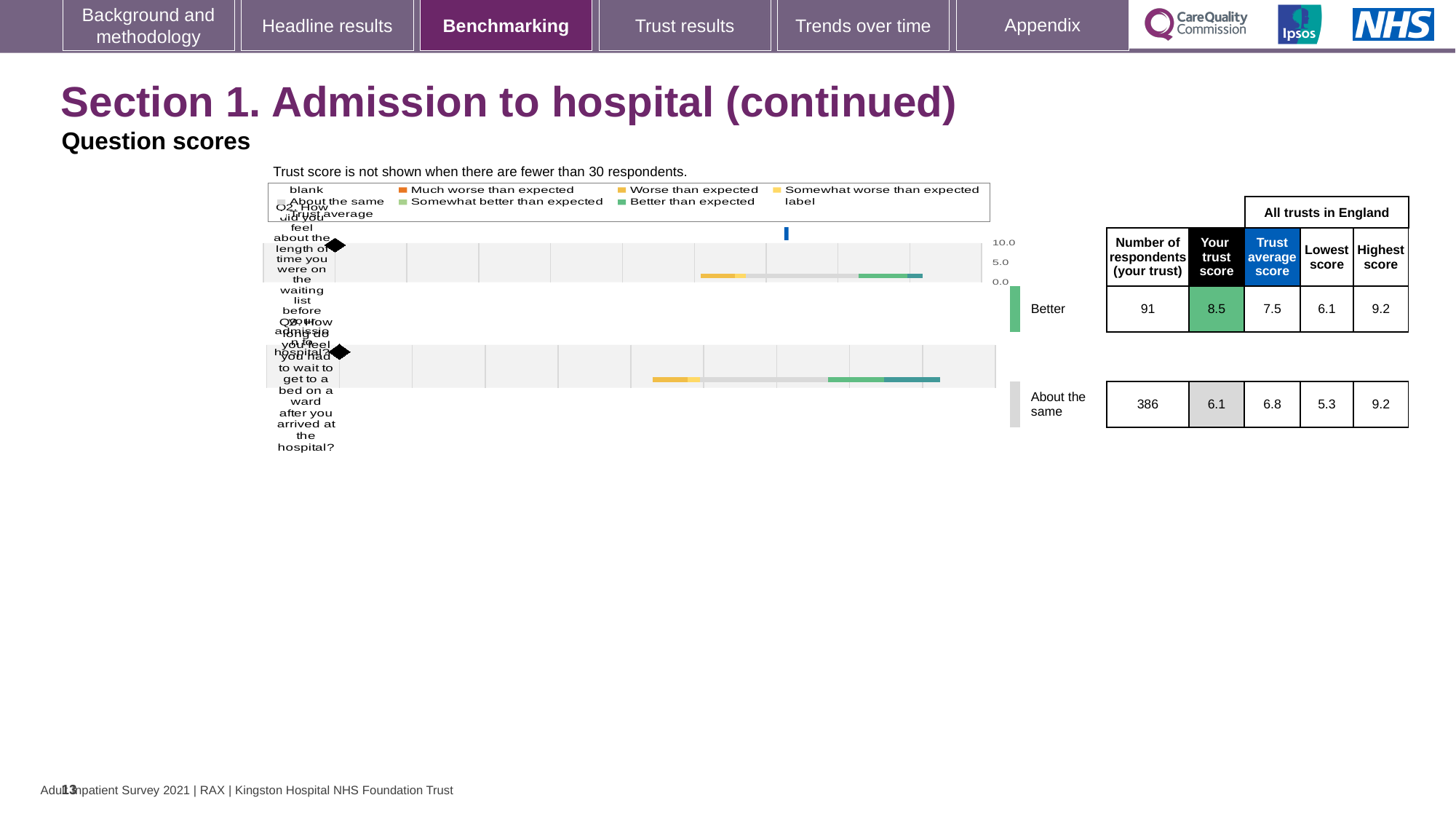
Which benchmark category is shown for Q3? About the same By how much does the trust score for Q2 exceed the trust average score for Q2? 1.0 What is the difference between the highest and lowest scores across all trusts for Q3? 3.9 What kind of chart is used to show the question scores on this slide? Bar chart What is the trust score for Q3 (how long did you feel you had to wait to get to a bed on a ward)? 6.1 How many respondents answered Q2 for this trust? 91 How many questions are plotted in the question scores chart? 2 What is the trust score for Q2 (how did you feel about the length of time on the waiting list before admission)? 8.5 Which benchmark category is shown for Q2? Better Which question has the higher trust score, Q2 or Q3? Q2 What is the trust average score across all trusts in England for Q3? 6.8 What is the highest score across all trusts in England for Q3? 9.2